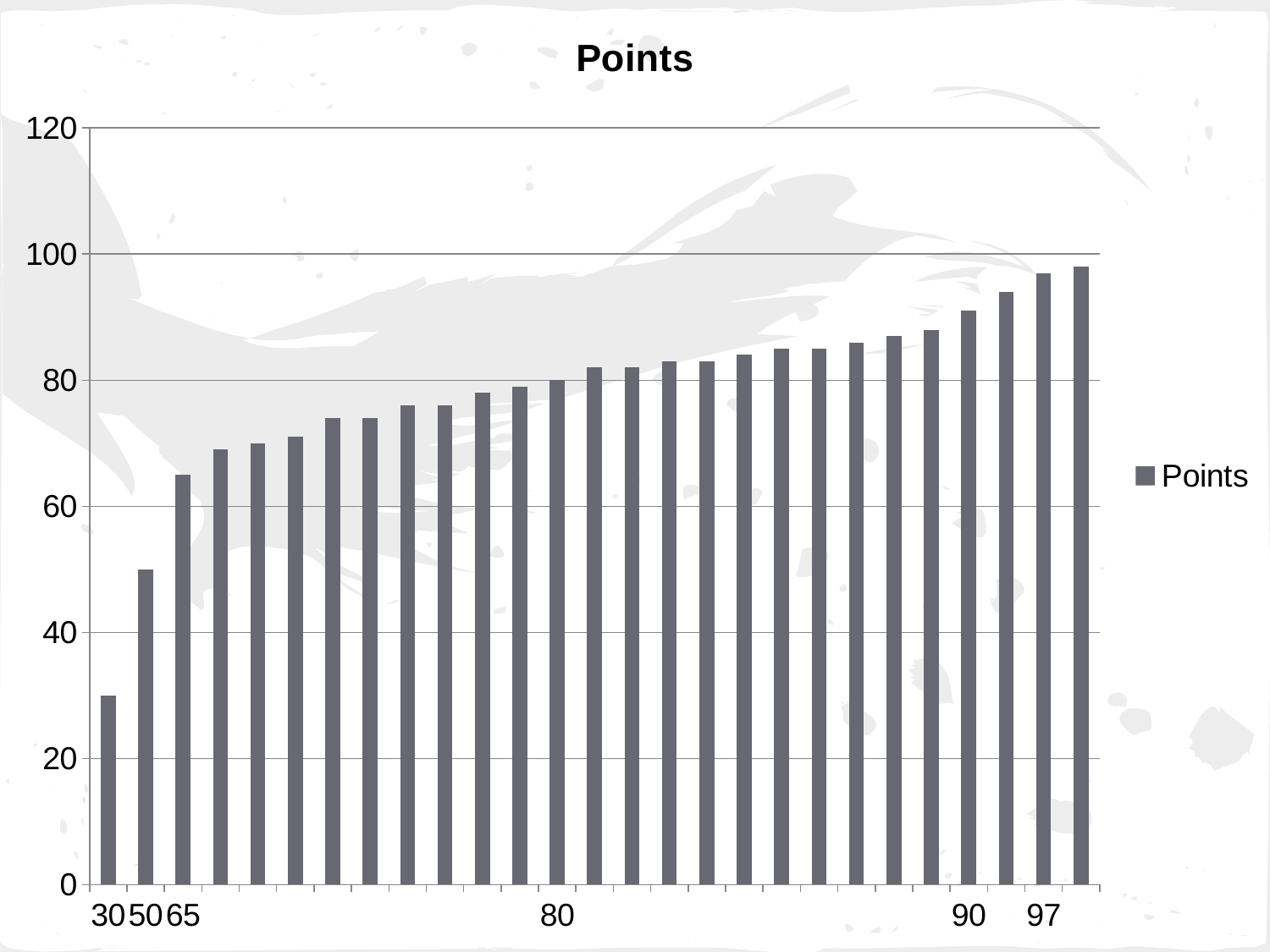
What is the value of the bar for the category labelled 80? 80 Is the value for the category labelled 90 greater or less than 80? greater Do the bar values rise or fall from left to right along the x axis? rise How many bars are plotted in the chart? 27 Which of the labelled categories, 50 or 65, has the larger bar? 65 Is the value for the category labelled 30 greater or less than 40? less What is the title of the chart? Points What kind of chart is shown on the slide? bar chart Is the value for the category labelled 65 greater or less than 60? greater What is the name of the series shown in the legend? Points How many series does the legend list? 1